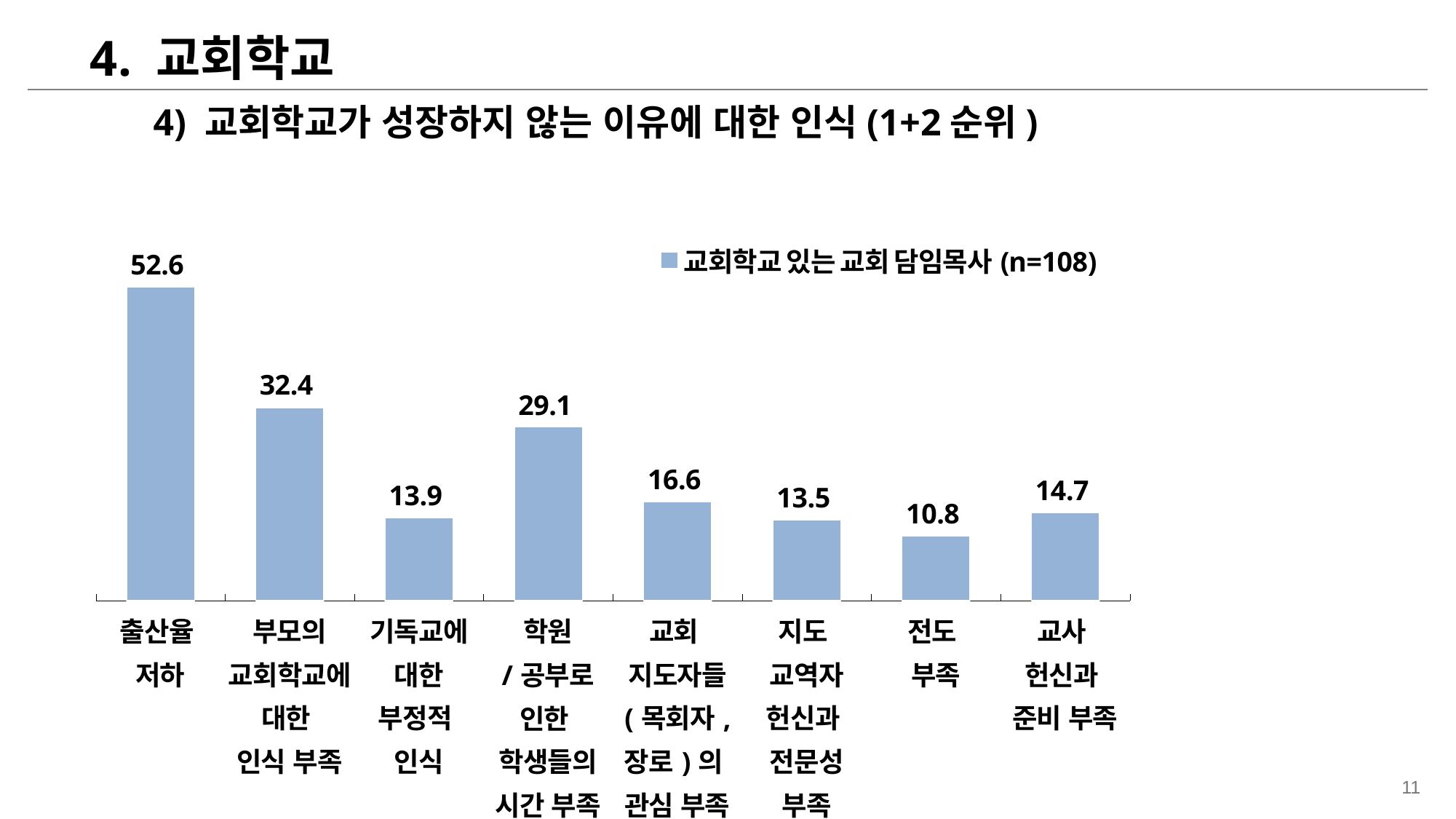
How many series does the legend list? 1 What is the difference between the values for 출산율 저하 and 부모의 교회학교에 대한 인식 부족? 20.2 What is the value for 교사 헌신과 준비 부족? 14.7 Which category has the highest value? 출산율 저하 What kind of chart is shown on the slide? bar chart Which is larger, the value for 기독교에 대한 부정적 인식 or the value for 교회 지도자들(목회자, 장로)의 관심 부족? 교회 지도자들(목회자, 장로)의 관심 부족 What is the value for 전도 부족? 10.8 How many categories are shown in the chart? 8 What is the legend entry for the series shown? 교회학교 있는 교회 담임목사 (n=108) What is the value for 출산율 저하? 52.6 Which category has the lowest value? 전도 부족 What is the value for 학원/공부로 인한 학생들의 시간 부족? 29.1